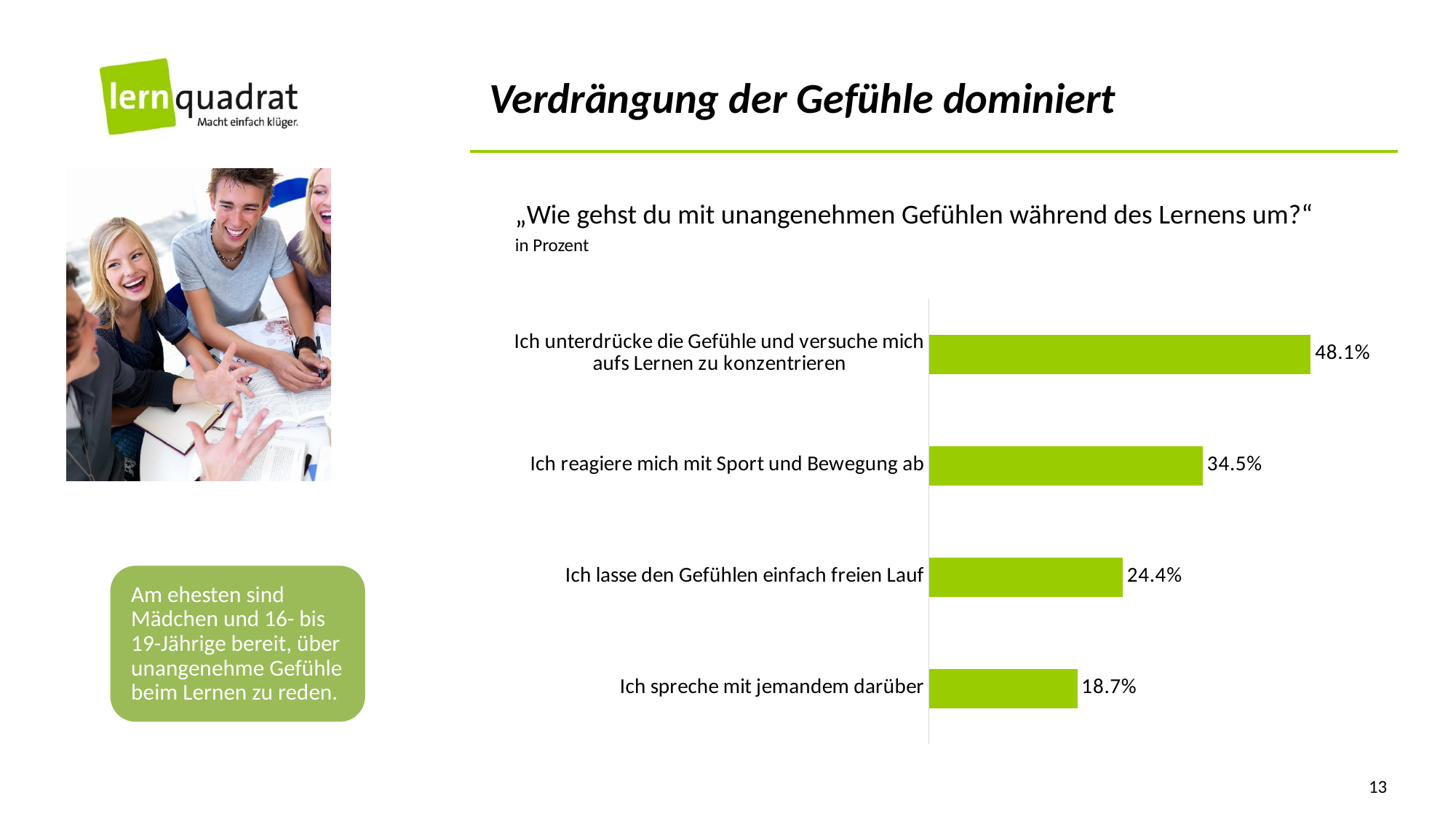
Which response has the highest percentage? Ich unterdrücke die Gefühle und versuche mich aufs Lernen zu konzentrieren What question is the chart based on, according to the chart heading? „Wie gehst du mit unangenehmen Gefühlen während des Lernens um?“ What percentage of respondents answered "Ich unterdrücke die Gefühle und versuche mich aufs Lernen zu konzentrieren"? 48.1% Which is larger: the value for "Ich reagiere mich mit Sport und Bewegung ab" or for "Ich lasse den Gefühlen einfach freien Lauf"? Ich reagiere mich mit Sport und Bewegung ab What is the difference in percentage points between "Ich reagiere mich mit Sport und Bewegung ab" and "Ich lasse den Gefühlen einfach freien Lauf"? 10.1 What is the value for "Ich lasse den Gefühlen einfach freien Lauf"? 24.4% What kind of chart is shown on the slide? Bar chart What is the difference in percentage points between "Ich unterdrücke die Gefühle und versuche mich aufs Lernen zu konzentrieren" and "Ich spreche mit jemandem darüber"? 29.4 Which response has the lowest percentage? Ich spreche mit jemandem darüber How many response categories are shown in the chart? 4 What is the value for "Ich reagiere mich mit Sport und Bewegung ab"? 34.5% What is the value for "Ich spreche mit jemandem darüber"? 18.7%